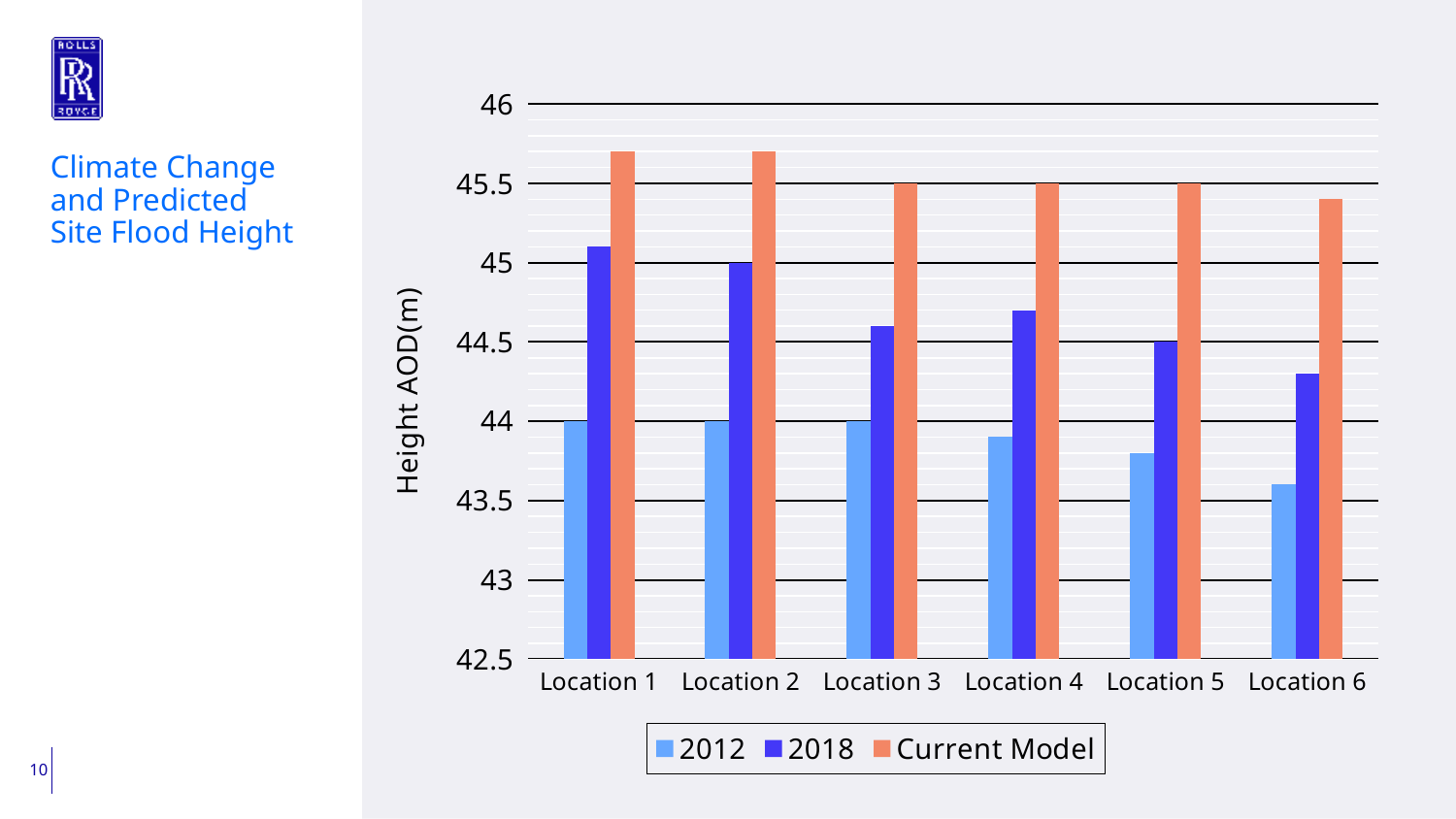
Which location has the lowest 2018 value? Location 6 What is the label on the vertical axis of the chart? Height AOD(m) Is the Current Model value for Location 1 greater or less than 45.5? greater Is the 2012 value for Location 6 greater or less than 44? less Which series are listed in the chart's legend? 2012, 2018, Current Model What is the Current Model value for Location 3? 45.5 What is the 2018 value for Location 2? 45 What is the 2012 value for Location 1? 44 What kind of chart is shown on the slide? bar chart Which is larger, the 2018 value for Location 1 or the 2018 value for Location 6? Location 1 How many series does the chart's legend list? 3 How many locations are shown on the x axis of the chart? 6